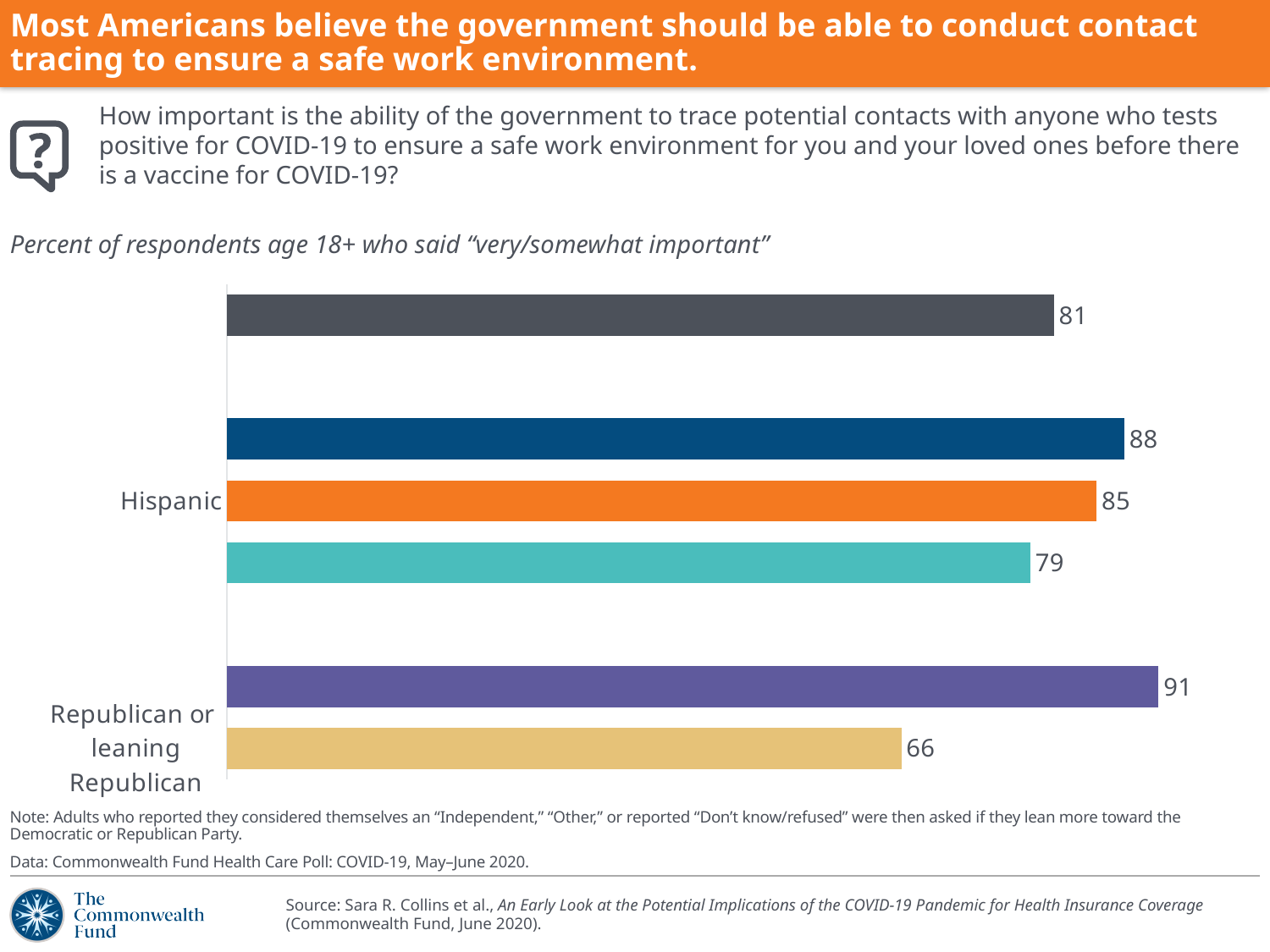
What is the difference between the value for Hispanic and the value for Republican or leaning Republican? 19 What does the chart subtitle say the values represent? Percent of respondents age 18+ who said "very/somewhat important" What is the value for Republican or leaning Republican? 66 Which is larger, the value for Hispanic or the value for Republican or leaning Republican? Hispanic How many bars are plotted on the chart? 6 What is the highest value shown on the chart? 91 What is the value of the topmost bar on the chart? 81 What is the value of the bar directly above the Hispanic bar? 88 Which labeled category has the lowest value? Republican or leaning Republican What is the lowest value shown on the chart? 66 What is the value for Hispanic? 85 What kind of chart is shown on the slide? Bar chart